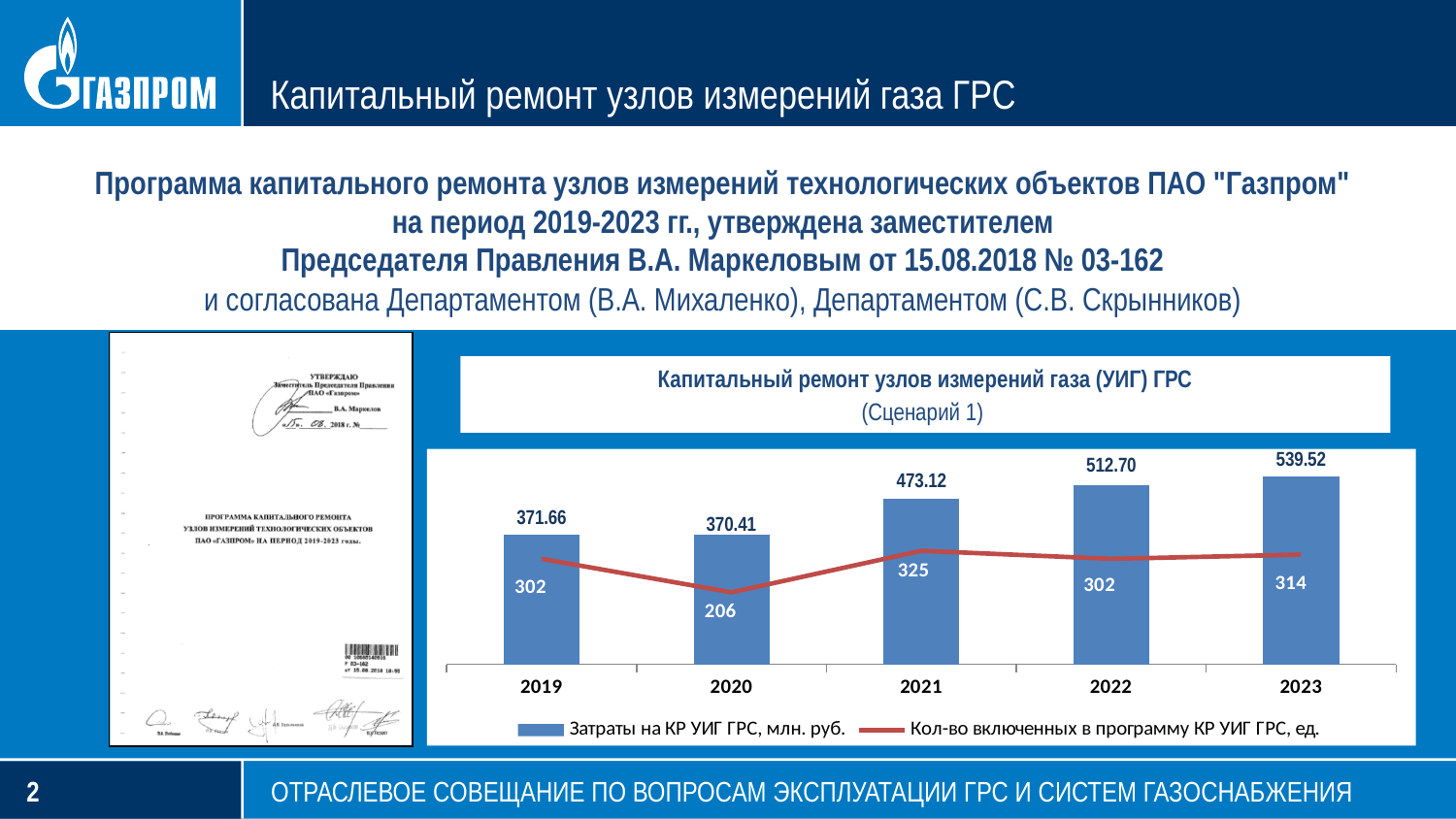
Which year has the highest value of Затраты на КР УИГ ГРС, млн. руб.? 2023 How many years are shown on the x axis of the chart? 5 What is the value of Затраты на КР УИГ ГРС, млн. руб. for 2021? 473.12 How many series does the chart legend list? 2 What is the value of Кол-во включенных в программу КР УИГ ГРС, ед. for 2020? 206 What is the value of Затраты на КР УИГ ГРС, млн. руб. for 2023? 539.52 Do the Затраты на КР УИГ ГРС, млн. руб. values rise or fall from 2020 to 2023? Rise What is the difference between the Затраты на КР УИГ ГРС, млн. руб. values for 2023 and 2022? 26.82 What kind of chart is used to show Затраты на КР УИГ ГРС, млн. руб.? Bar chart Which year has the larger value of Затраты на КР УИГ ГРС, млн. руб.: 2021 or 2022? 2022 Which year has the lowest value of Кол-во включенных в программу КР УИГ ГРС, ед.? 2020 What is the difference between the Кол-во включенных в программу КР УИГ ГРС, ед. values for 2021 and 2020? 119